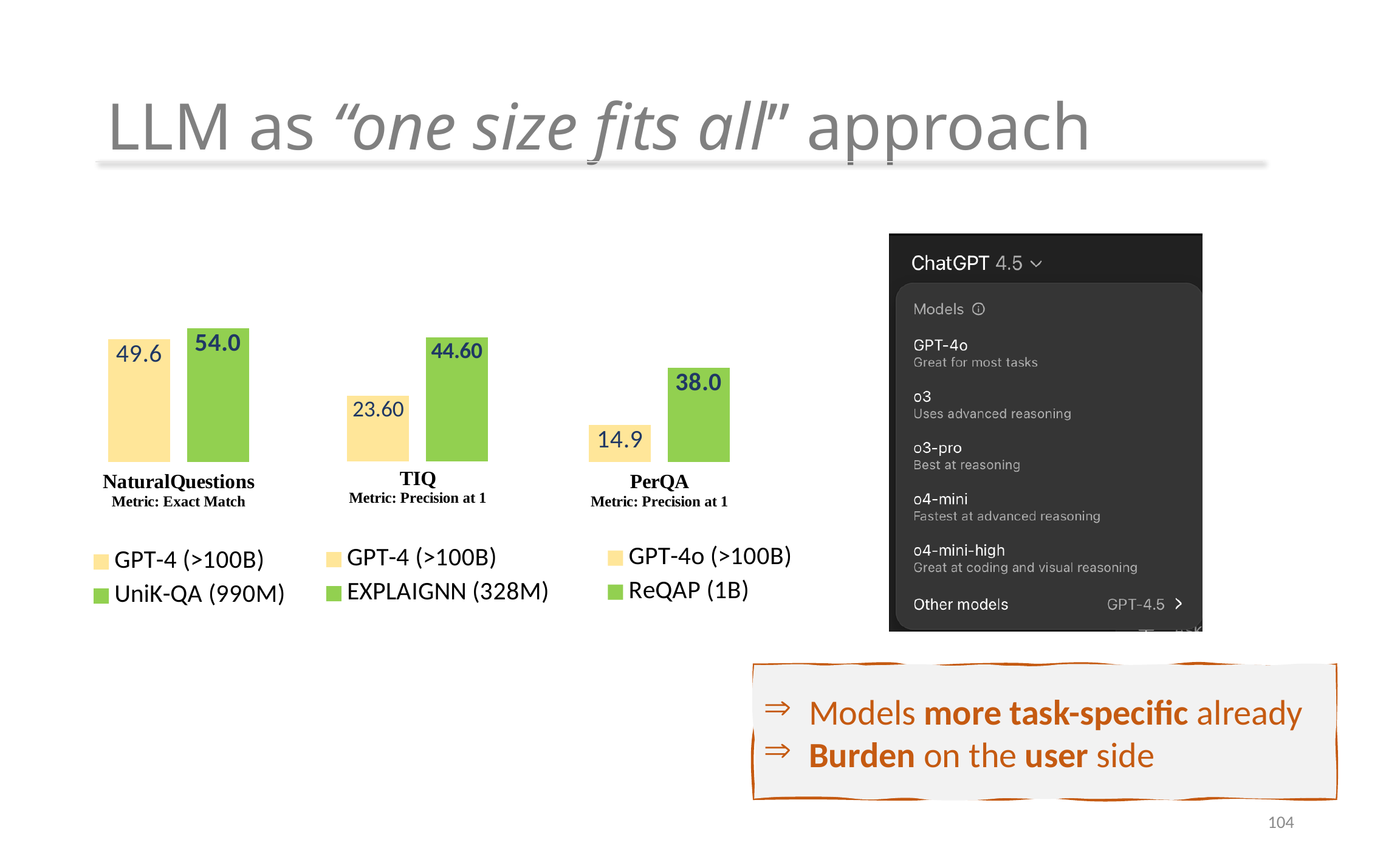
What kind of chart is used for the NaturalQuestions, TIQ and PerQA results? Bar chart In the NaturalQuestions chart, what is the value for UniK-QA (990M)? 54.0 In the NaturalQuestions chart, which is larger: the value for GPT-4 (>100B) or the value for UniK-QA (990M)? UniK-QA (990M) In the PerQA chart, what is the difference between the ReQAP (1B) value and the GPT-4o (>100B) value? 23.1 In the PerQA chart, what is the value for GPT-4o (>100B)? 14.9 In the TIQ chart, what is the value for EXPLAIGNN (328M)? 44.60 In the PerQA chart, which model has the lower value? GPT-4o (>100B) In the TIQ chart, what is the difference between the EXPLAIGNN (328M) value and the GPT-4 (>100B) value? 21.00 In the TIQ chart, which model has the higher value? EXPLAIGNN (328M) In the NaturalQuestions chart, what is the value for GPT-4 (>100B)? 49.6 In the TIQ chart, what is the value for GPT-4 (>100B)? 23.60 In the PerQA chart, what is the value for ReQAP (1B)? 38.0